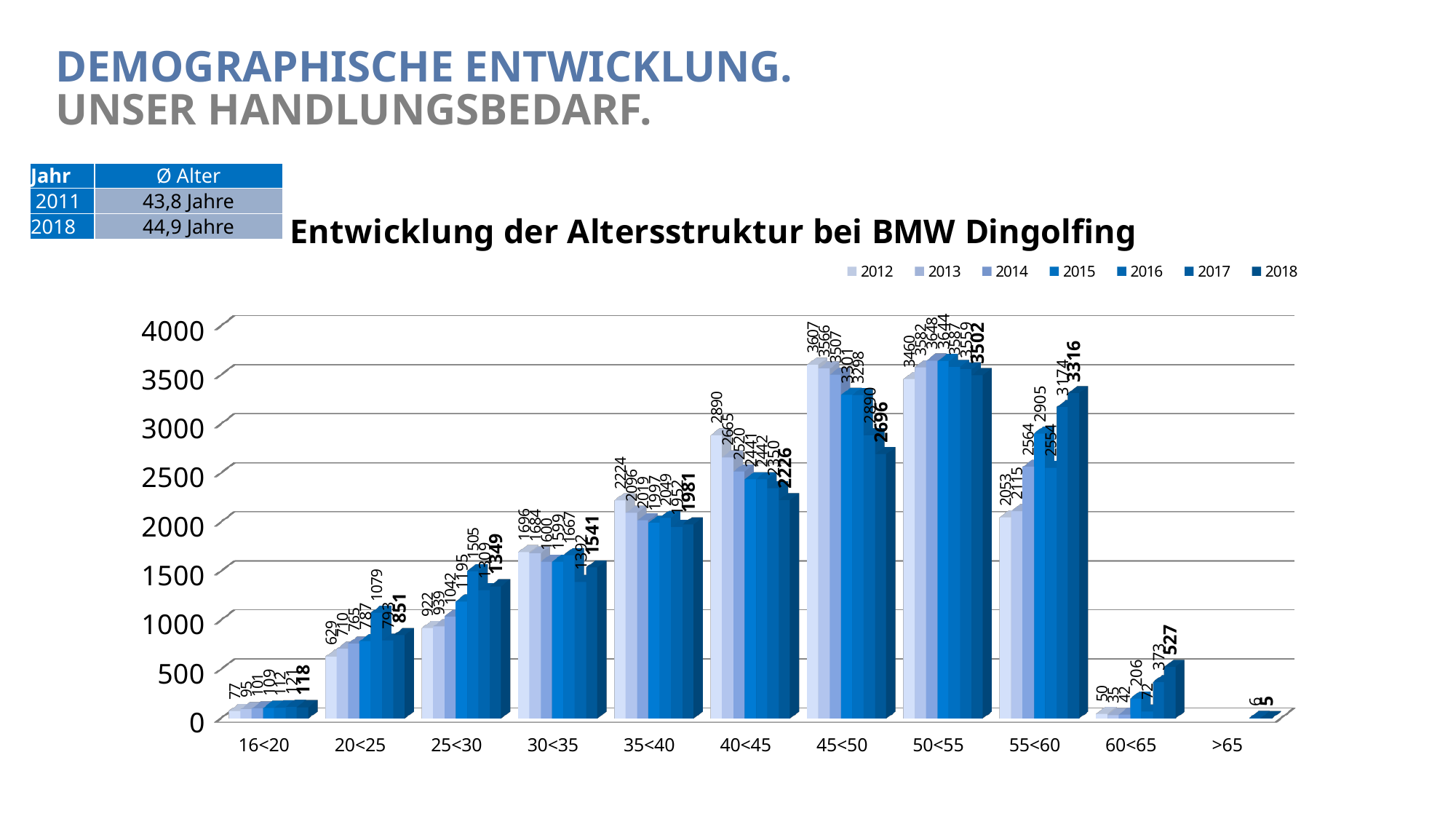
What is the 2018 value for the 16<20 age group? 118 How many series does the chart legend list? 7 What is the 2018 value for the 50<55 age group? 3502 What is the 2018 value for the 55<60 age group? 3316 How many age-group categories are shown on the x axis? 11 What is the 2012 value for the 45<50 age group? 3607 What kind of chart is shown on the slide? bar chart Which age group has the highest 2018 value? 50<55 What is the title of the chart? Entwicklung der Altersstruktur bei BMW Dingolfing Is the 2018 value for the 45<50 age group larger or smaller than the 2012 value for that group? smaller Which age group has the lowest 2018 value? >65 What is the difference between the 2018 values for 55<60 (3316) and 60<65 (527)? 2789